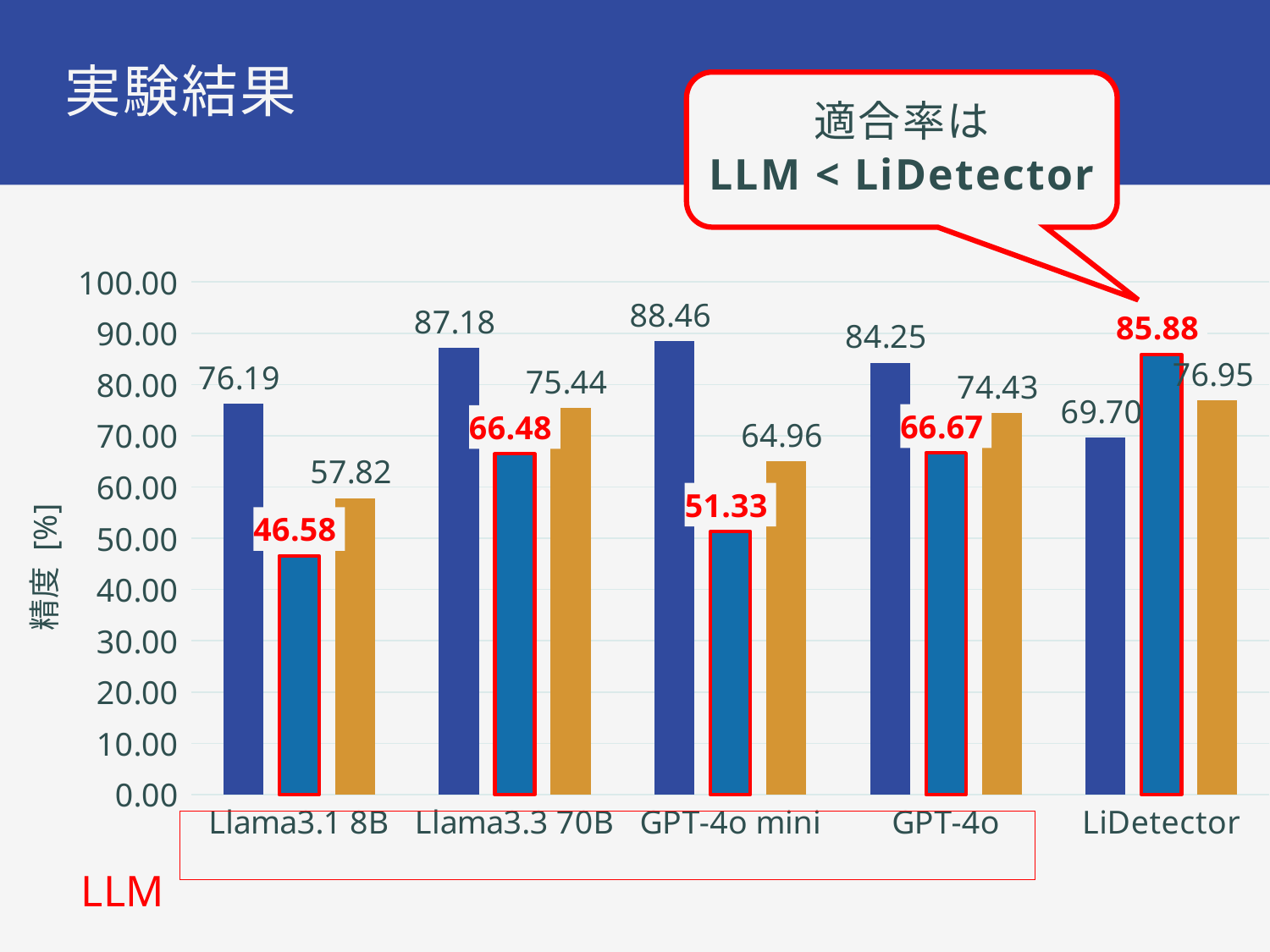
Is the light blue bar for GPT-4o mini greater or less than 60.00? less What is the value of the orange bar for Llama3.1 8B? 57.82 Which category has the highest orange bar? LiDetector How many categories are shown on the x axis of the chart? 5 Which is larger: the orange bar for Llama3.3 70B or the orange bar for GPT-4o? Llama3.3 70B What is the difference between the light blue bar for LiDetector and the light blue bar for GPT-4o? 19.21 Which category has the highest dark blue bar? GPT-4o mini What is the label of the y axis of the chart? 精度 [%] What is the value of the dark blue bar for GPT-4o mini? 88.46 Which category has the lowest light blue (red-outlined) bar? Llama3.1 8B What kind of chart is shown on the slide? bar chart What is the value of the light blue (red-outlined) bar for LiDetector? 85.88